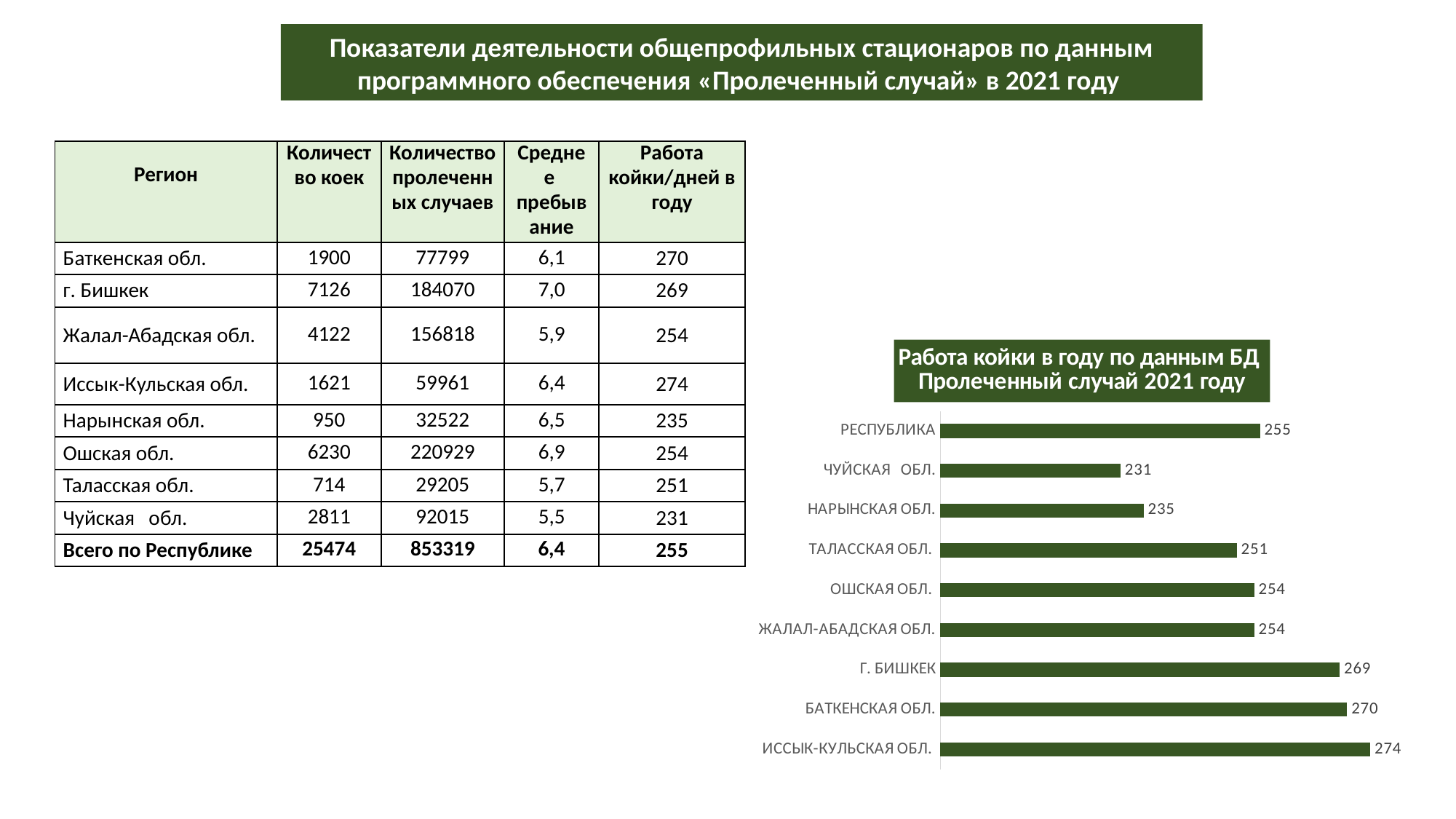
Which is larger, the value for БАТКЕНСКАЯ ОБЛ. or the value for НАРЫНСКАЯ ОБЛ.? БАТКЕНСКАЯ ОБЛ. What is the value for РЕСПУБЛИКА in the chart? 255 How many categories are shown in the chart? 9 What is the value for ИССЫК-КУЛЬСКАЯ ОБЛ. in the chart? 274 What is the difference between the values for Г. БИШКЕК and ТАЛАССКАЯ ОБЛ.? 18 What kind of chart is shown on the slide? Bar chart What is the value for ОШСКАЯ ОБЛ. in the chart? 254 Which category has the highest value in the chart? ИССЫК-КУЛЬСКАЯ ОБЛ. What is the value for ЧУЙСКАЯ ОБЛ. in the chart? 231 What is the difference between the values for ИССЫК-КУЛЬСКАЯ ОБЛ. and ЧУЙСКАЯ ОБЛ.? 43 Which category has the lowest value in the chart? ЧУЙСКАЯ ОБЛ. What is the title of the chart? Работа койки в году по данным БД Пролеченный случай 2021 году